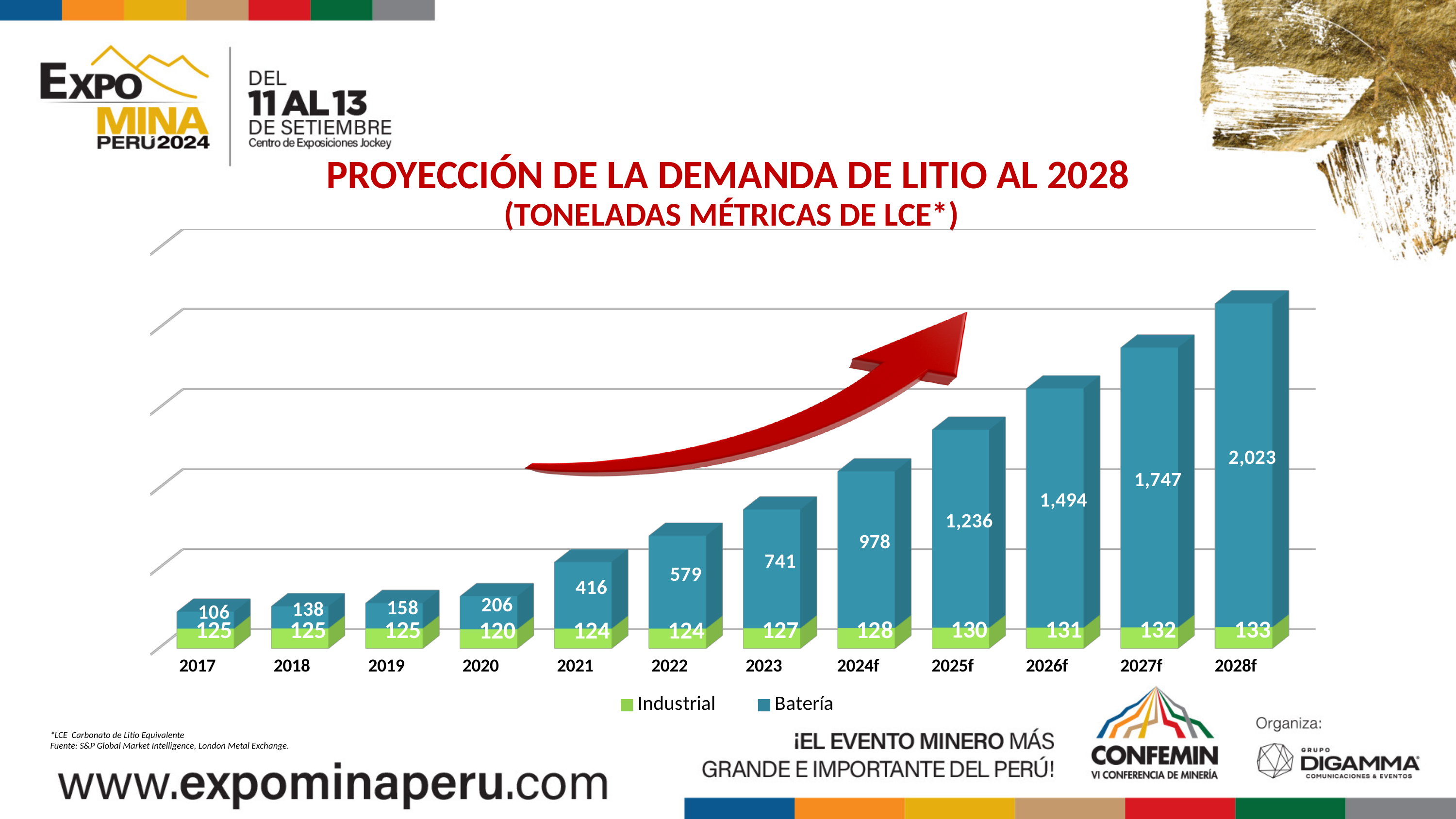
What is the difference between the Batería values for 2028f and 2027f? 276 What is the total of the stacked bar for 2017? 231 What is the Industrial value for 2020? 120 What is the Batería value for 2028f? 2,023 What kind of chart is shown? Stacked bar chart Which year has the highest Industrial value? 2028f Do the Batería values rise or fall from 2017 to 2028f? Rise What is the Batería value for 2021? 416 Which is larger, the Batería value for 2023 or for 2024f? 2024f How many years are shown on the x axis? 12 How many series does the legend list? 2 Which year has the lowest Batería value? 2017